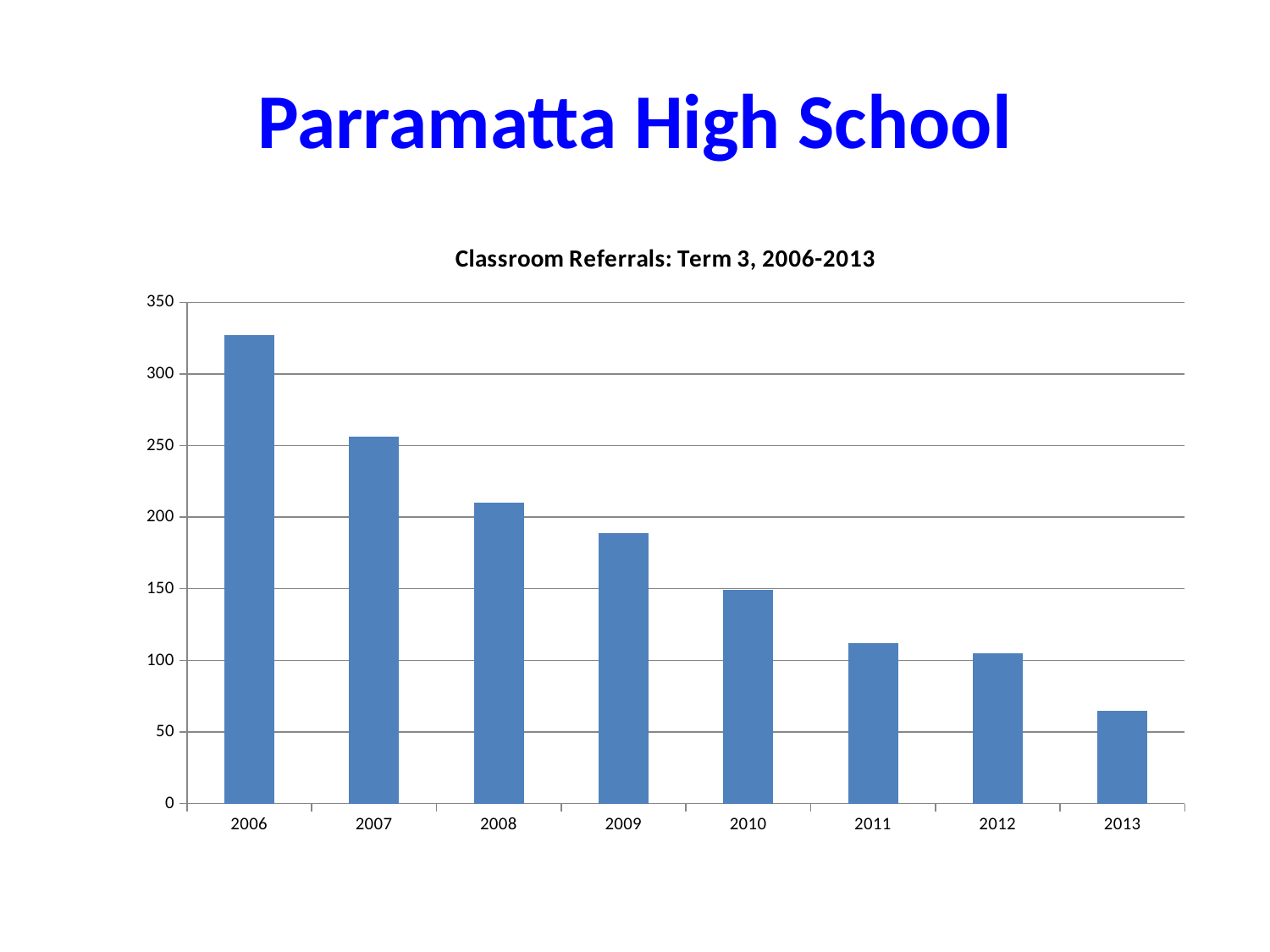
Which year has more classroom referrals, 2008 or 2010? 2008 Is the value for 2009 greater or less than 200? less Do the classroom referrals rise or fall from 2006 to 2013? Fall How many years are shown on the x axis of the chart? 8 Is the value for 2013 greater or less than 100? less What type of chart is shown on the slide? Bar chart What is the title of the chart? Classroom Referrals: Term 3, 2006-2013 Is the value for 2006 greater or less than 300? greater Which year has the highest number of classroom referrals? 2006 Which year has more classroom referrals, 2012 or 2013? 2012 Which year has the lowest number of classroom referrals? 2013